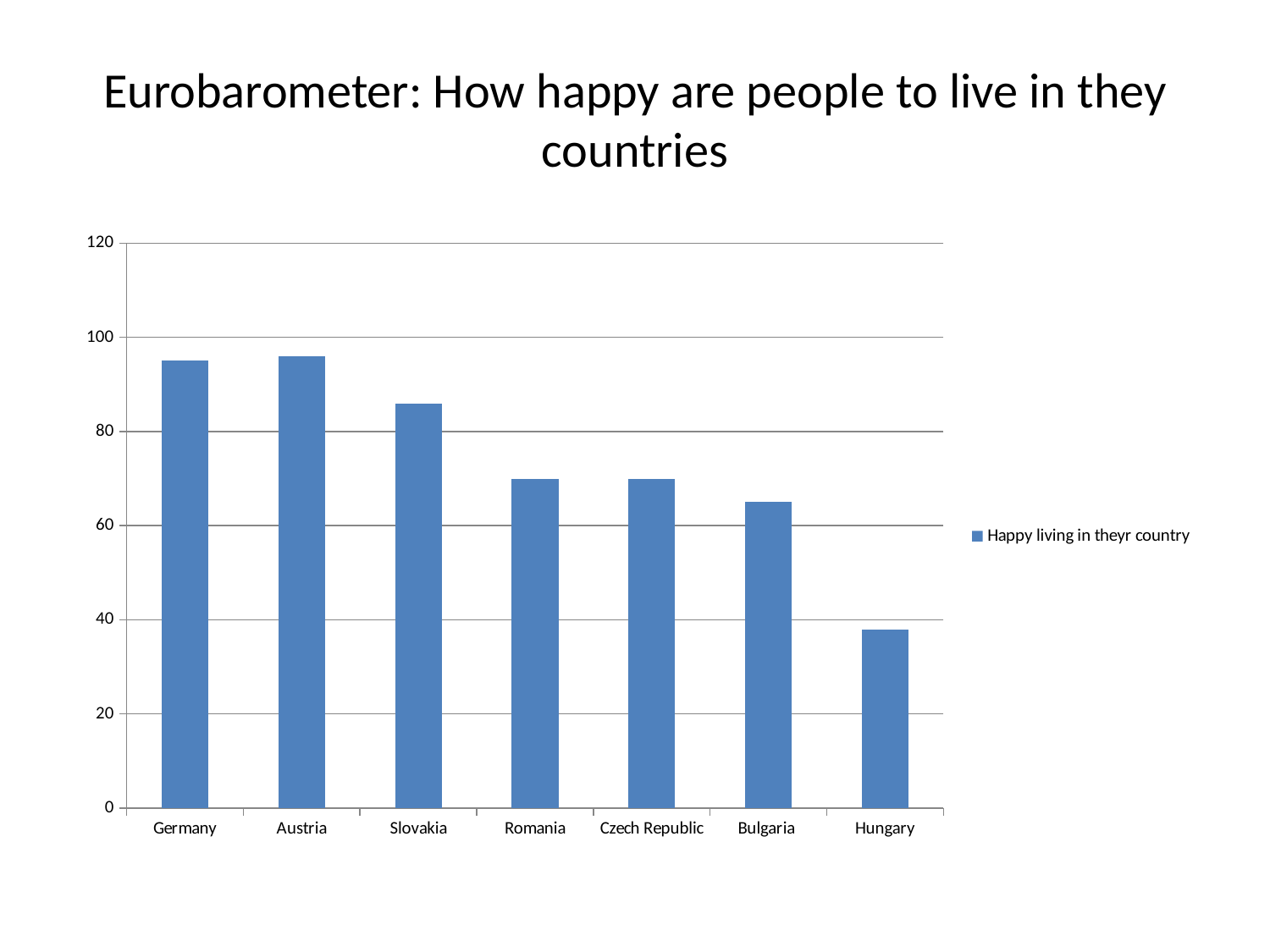
What kind of chart is shown on the slide? bar chart Is the value for Germany greater or less than 80? greater What is the name of the series shown in the legend? Happy living in theyr country Do the values generally rise or fall moving from Germany to Hungary along the x axis? fall Which has the larger value, Slovakia or Romania? Slovakia Is the value for Bulgaria greater or less than 60? greater Is the value for Slovakia greater or less than 80? greater Which country has the lowest bar in the chart? Hungary How many series does the legend list? 1 How many countries are shown on the x axis of the chart? 7